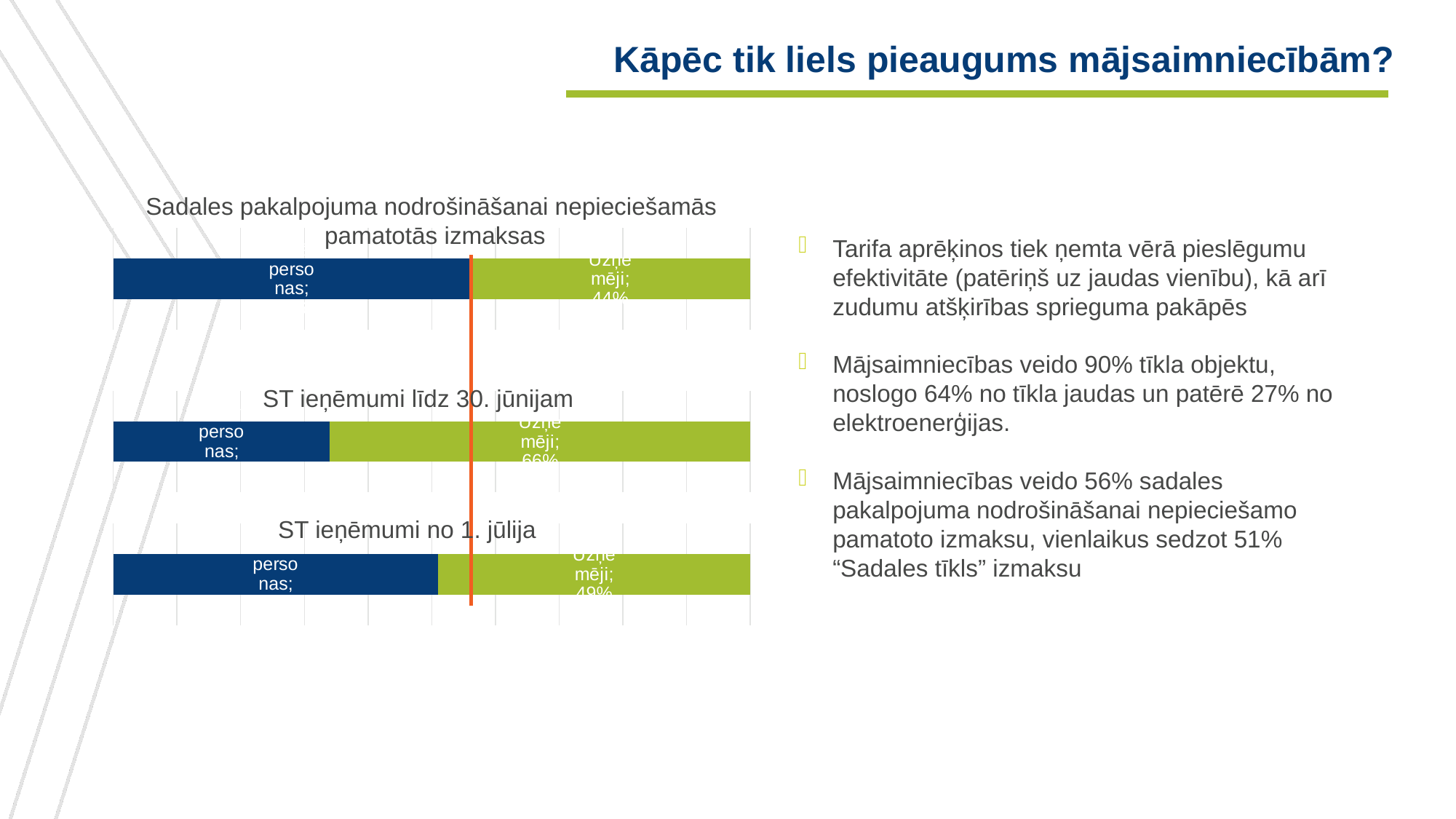
What colour is the 'personas' segment in the bars? Dark blue How many separate bar charts are shown on the slide? 3 What is the difference between the Uzņēmēji share in 'ST ieņēmumi līdz 30. jūnijam' and in 'Sadales pakalpojuma nodrošināšanai nepieciešamās pamatotās izmaksas'? 22 percentage points How many segments (series) does each stacked bar contain? 2 Across the three charts, which chart shows the largest share for Uzņēmēji? ST ieņēmumi līdz 30. jūnijam In the chart titled 'ST ieņēmumi līdz 30. jūnijam', what is the value for Uzņēmēji? 66% Across the three charts, which chart shows the smallest share for Uzņēmēji? Sadales pakalpojuma nodrošināšanai nepieciešamās pamatotās izmaksas In the chart titled 'ST ieņēmumi līdz 30. jūnijam', which segment is larger, personas or Uzņēmēji? Uzņēmēji In the chart titled 'Sadales pakalpojuma nodrošināšanai nepieciešamās pamatotās izmaksas', which segment is larger, personas or Uzņēmēji? personas In the chart titled 'ST ieņēmumi no 1. jūlija', what is the value for Uzņēmēji? 49% What kind of chart is used on this slide? Bar chart In the chart titled 'Sadales pakalpojuma nodrošināšanai nepieciešamās pamatotās izmaksas', what is the value for Uzņēmēji? 44%